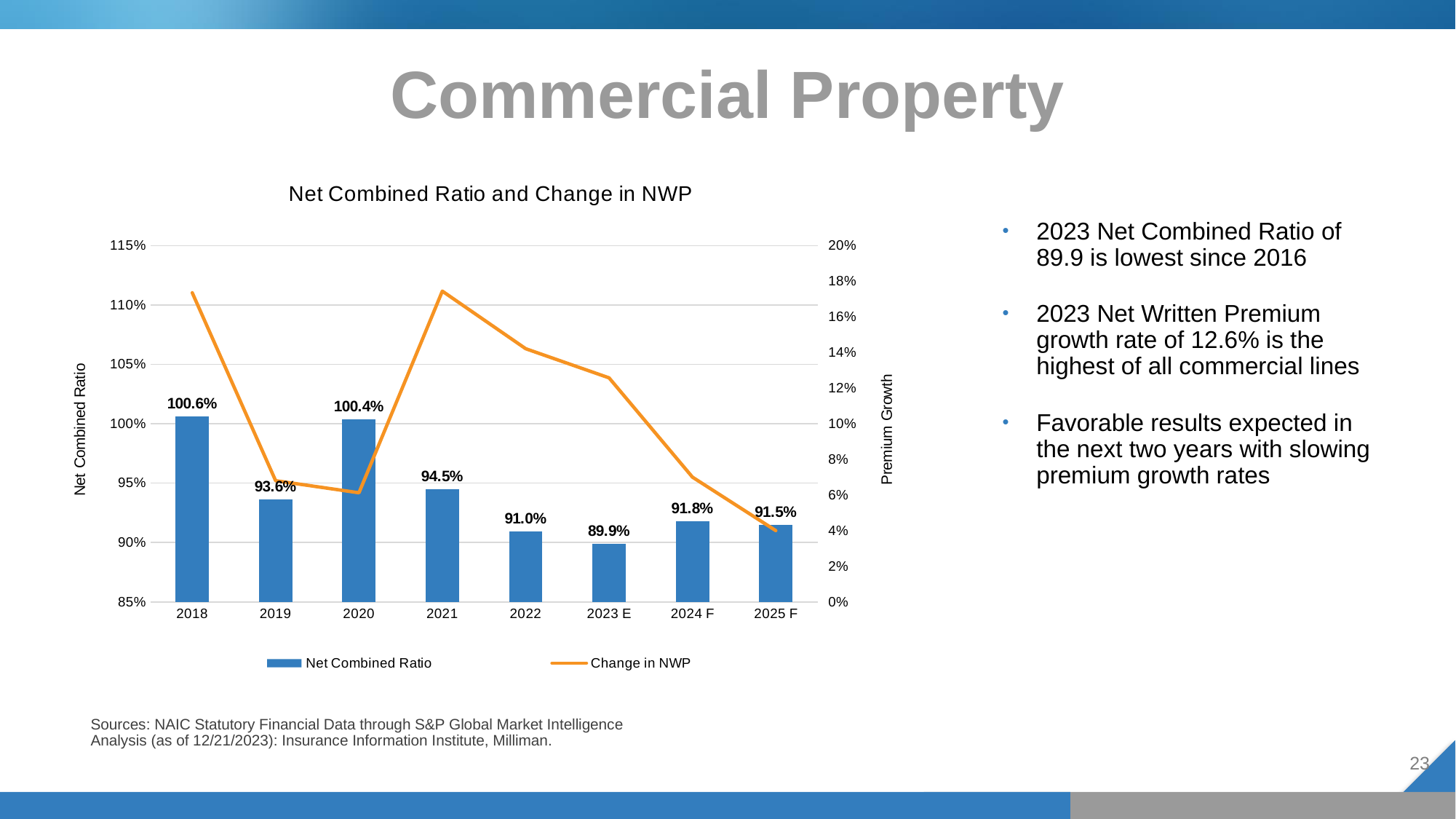
What is the Net Combined Ratio for 2025 F? 91.5% What is the Net Combined Ratio for 2023 E? 89.9% How many years are shown on the x axis? 8 Is the Change in NWP for 2025 F greater or less than 6%? less Which year has the highest Net Combined Ratio? 2018 Which is larger, the Net Combined Ratio for 2021 or for 2022? 2021 How many series does the legend list? 2 What is the Net Combined Ratio for 2018? 100.6% What is the title of the chart? Net Combined Ratio and Change in NWP What is the difference between the Net Combined Ratio in 2018 and in 2019? 7.0% Is the Change in NWP for 2018 greater or less than 16%? greater Which year has the lowest Net Combined Ratio? 2023 E